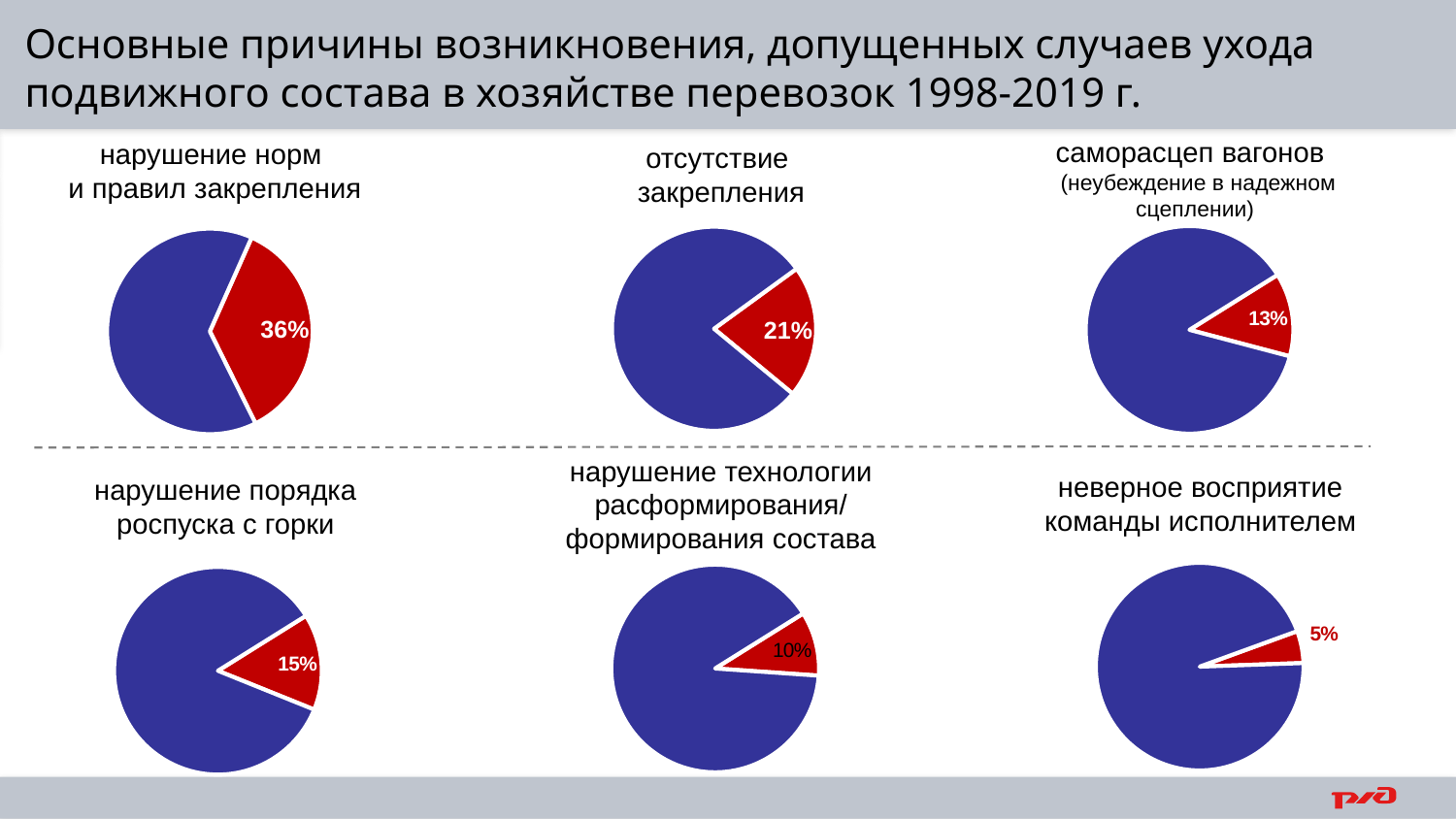
Across all six pie charts on the slide, which cause has the smallest labelled share? неверное восприятие команды исполнителем In the pie chart titled "неверное восприятие команды исполнителем", what percentage is labelled on the red slice? 5% In the pie chart titled "нарушение норм и правил закрепления", what percentage does the red slice show? 36% Which labelled share is larger: the one in the "отсутствие закрепления" chart or the one in the "нарушение порядка роспуска с горки" chart? отсутствие закрепления In the pie chart titled "саморасцеп вагонов", what percentage does the red slice show? 13% In the pie chart titled "нарушение порядка роспуска с горки", what percentage is labelled on the red slice? 15% In the pie chart titled "нарушение технологии расформирования/формирования состава", what percentage does the red slice show? 10% What is the difference between the labelled share in the "нарушение норм и правил закрепления" chart and the labelled share in the "отсутствие закрепления" chart? 15% In the pie chart titled "отсутствие закрепления", what percentage is labelled on the red slice? 21% Across all six pie charts on the slide, which cause has the largest labelled share? нарушение норм и правил закрепления What type of chart is used for each of the six causes on the slide? pie chart How many pie charts are shown on the slide? 6